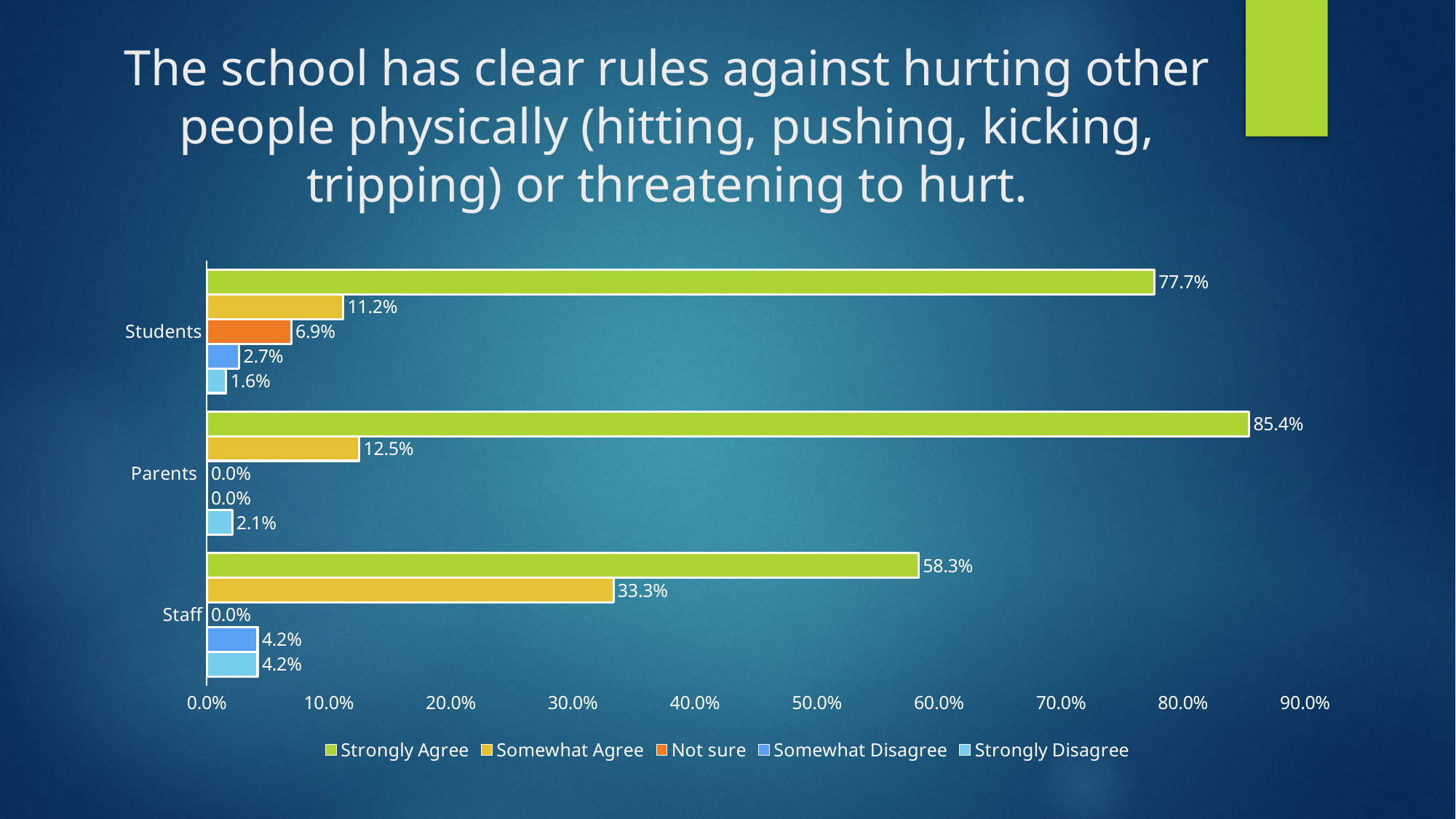
What percentage of Parents responded Somewhat Agree? 12.5% Which group has the lowest Strongly Agree percentage? Staff How many groups are shown on the y axis? 3 What is the difference between the Strongly Agree percentages for Parents and Staff? 27.1% Is the Strongly Agree value for Students greater or less than 70.0%? greater What percentage of Staff responded Strongly Agree? 58.3% What percentage of Students responded Not sure? 6.9% What kind of chart is shown on the slide? Bar chart How many series does the legend list? 5 What percentage of Students responded Strongly Agree? 77.7% Which is larger: the Somewhat Agree percentage for Staff or for Students? Staff Which group has the highest Strongly Agree percentage? Parents